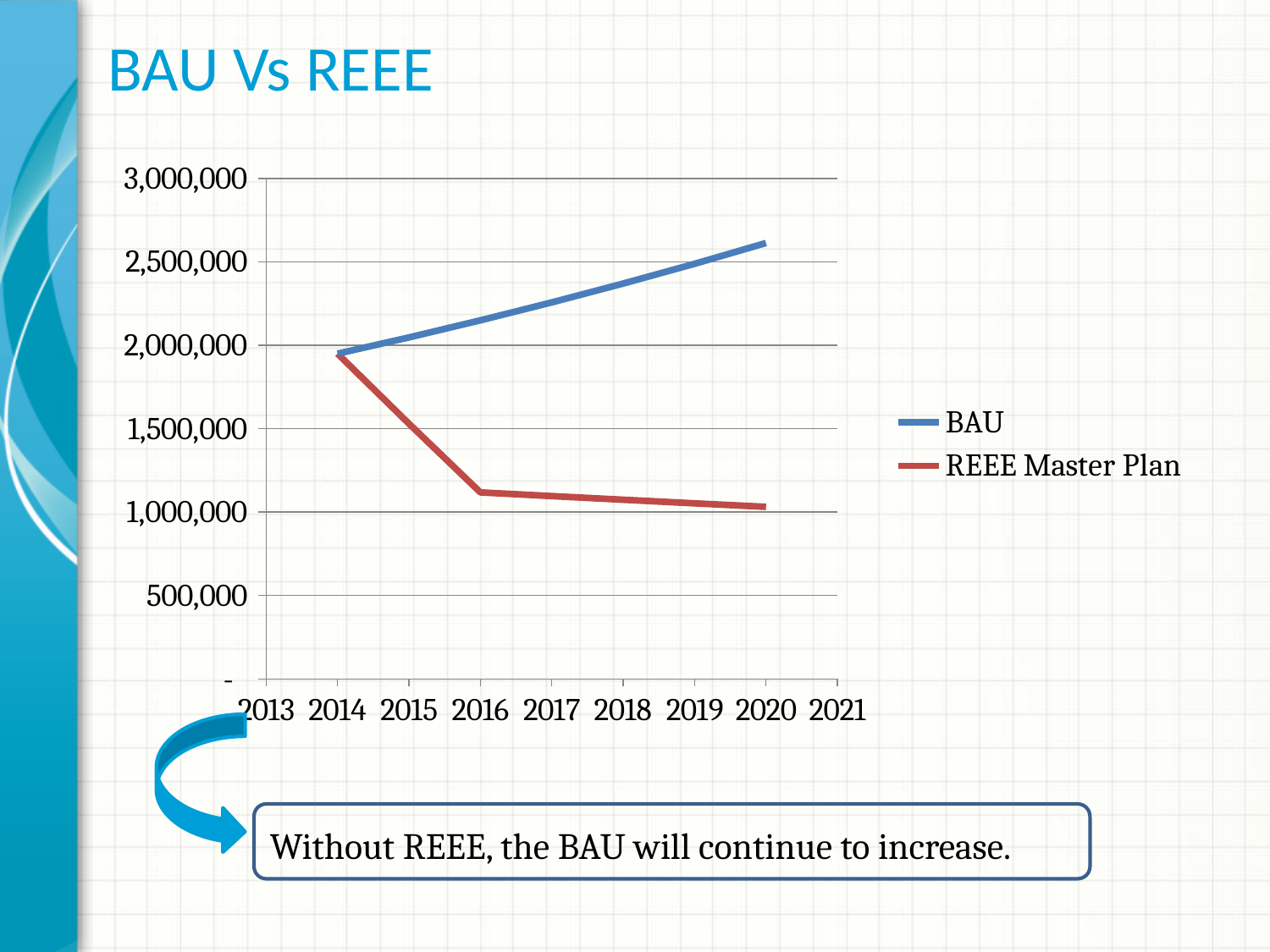
In 2020, which series has the higher value, BAU or REEE Master Plan? BAU How many year labels are shown on the x axis? 9 Is the REEE Master Plan value in 2020 greater or less than 1,500,000? less Is the BAU value in 2020 greater or less than 2,500,000? greater What is the title of the slide containing the chart? BAU Vs REEE Does the REEE Master Plan line rise or fall from 2014 to 2020? fall Is the BAU value in 2014 greater or less than 2,500,000? less What are the two series named in the legend? BAU and REEE Master Plan How many series does the legend list? 2 Does the BAU line rise or fall from 2014 to 2020? rise What kind of chart is shown on the slide? line chart